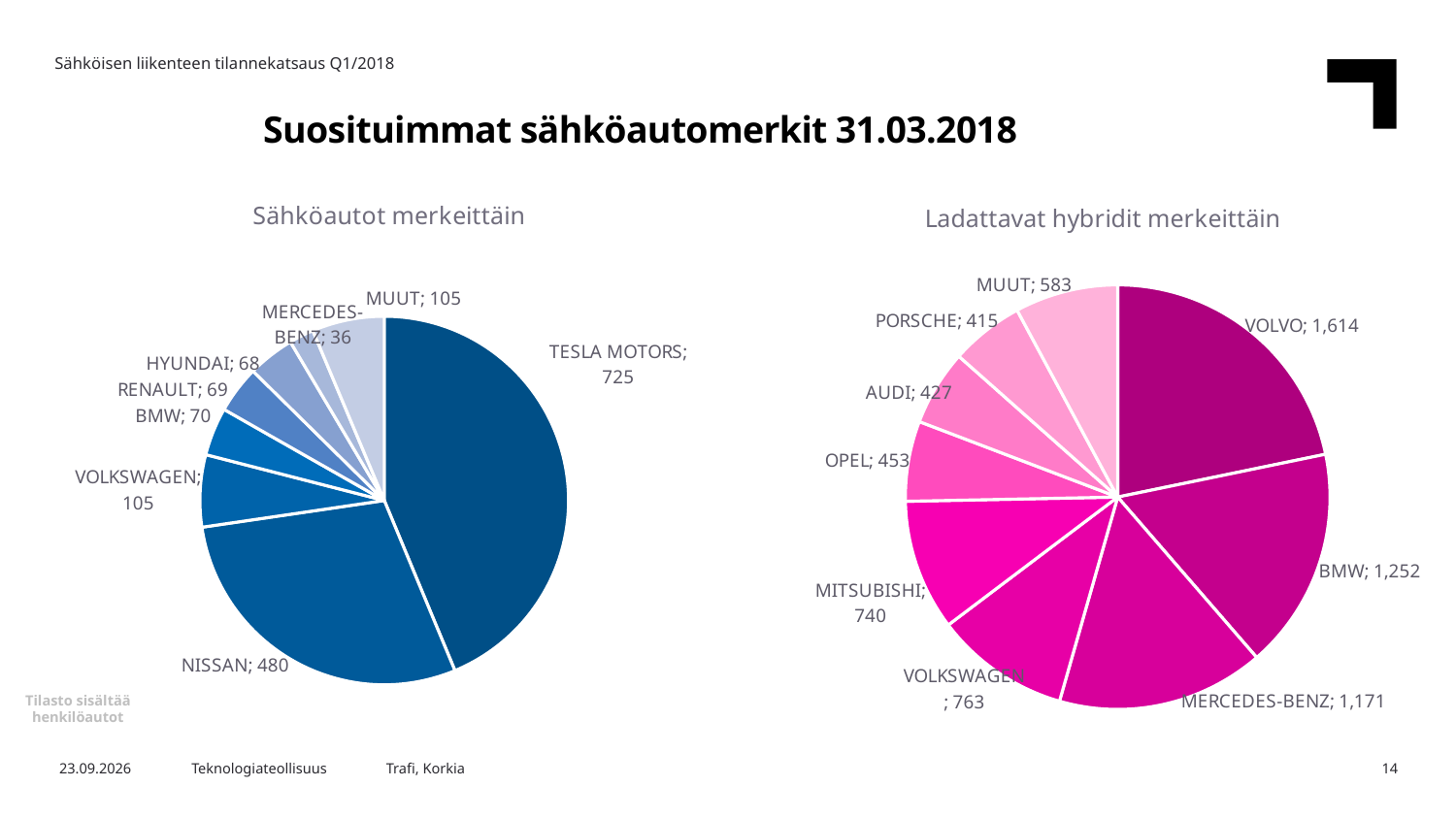
In the 'Sähköautot merkeittäin' chart, which brand has the largest slice? TESLA MOTORS How many slices does the 'Ladattavat hybridit merkeittäin' chart have? 9 In the 'Ladattavat hybridit merkeittäin' chart, which brand has the largest slice? VOLVO In the 'Ladattavat hybridit merkeittäin' chart, what is the value for MERCEDES-BENZ? 1,171 In the 'Ladattavat hybridit merkeittäin' chart, which is larger, VOLKSWAGEN or MITSUBISHI? VOLKSWAGEN In the 'Sähköautot merkeittäin' chart, what is the value for TESLA MOTORS? 725 In the 'Sähköautot merkeittäin' chart, what is the difference between TESLA MOTORS and NISSAN? 245 In the 'Sähköautot merkeittäin' chart, which brand has the smallest slice? MERCEDES-BENZ In the 'Ladattavat hybridit merkeittäin' chart, which brand has the smallest slice? PORSCHE How many slices does the 'Sähköautot merkeittäin' chart have? 8 In the 'Ladattavat hybridit merkeittäin' chart, what is the difference between VOLVO and BMW? 362 What type of chart is the 'Ladattavat hybridit merkeittäin' chart? Pie chart